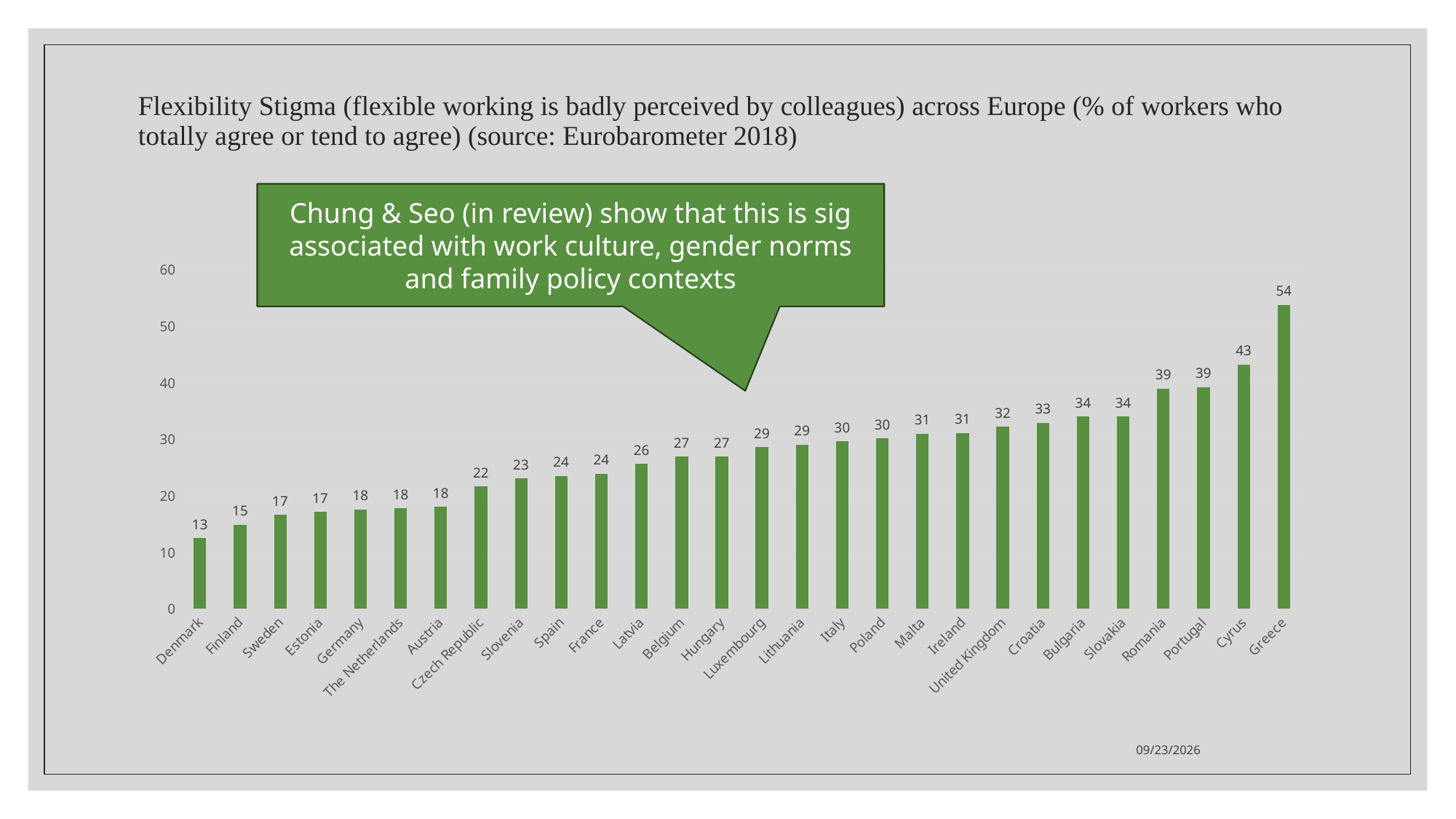
What is the difference between the values for Greece and Denmark? 41 Which is larger, the value for Latvia or the value for Hungary? Hungary What kind of chart is shown on the slide? bar chart Is the value for Romania greater or less than 30? greater What is the value for Denmark? 13 Do the values rise or fall from left to right along the x axis? rise Which country has the highest value? Greece Which country has the lowest value? Denmark What is the value for the United Kingdom? 32 What is the difference between the values for Croatia and Spain? 9 How many countries are shown on the chart? 28 What is the value for Portugal? 39